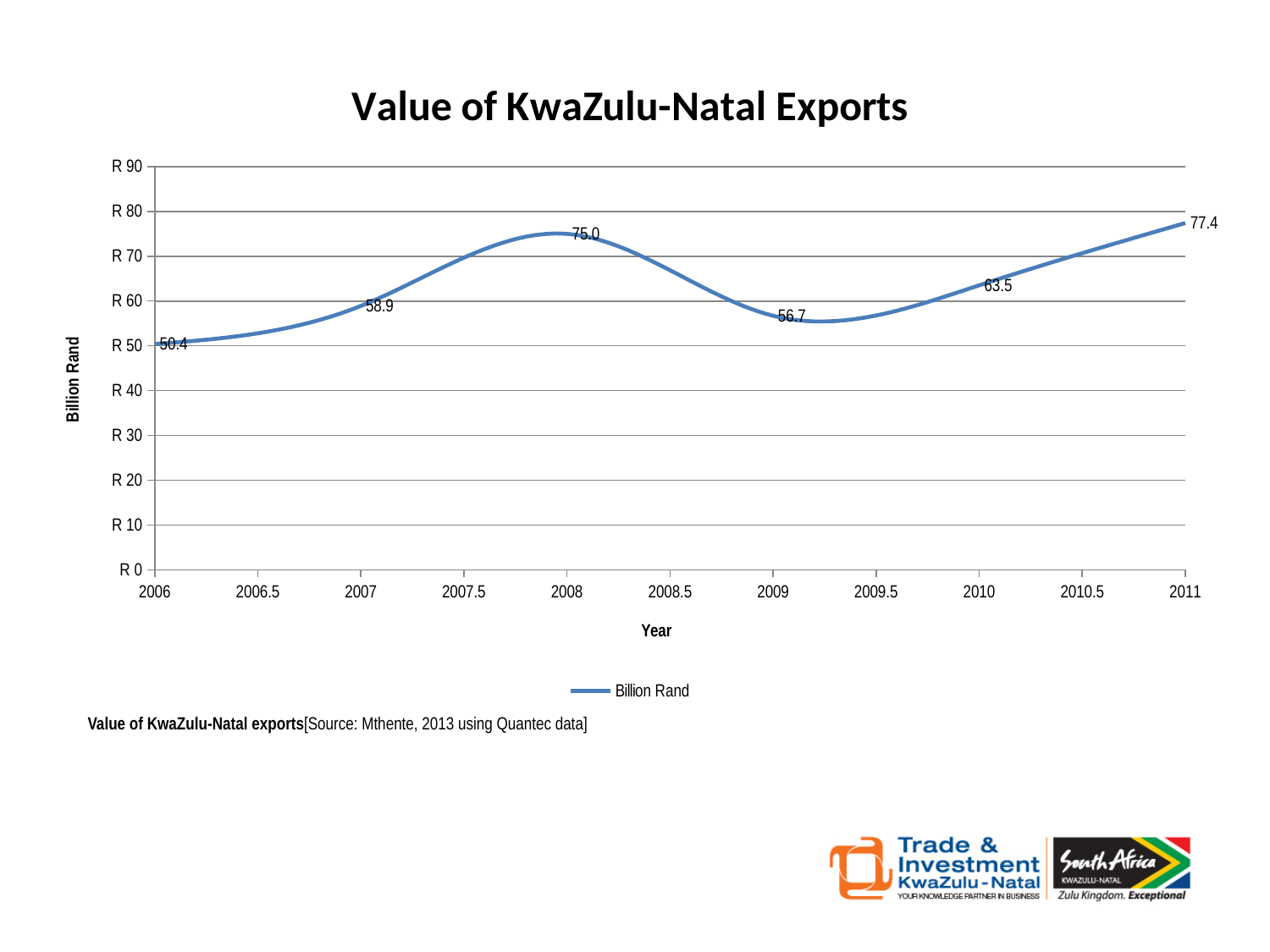
What is the difference between the export values for 2011 and 2006? 27.0 Is the export value for 2009 greater or less than R 60? less What is the label on the vertical axis of the chart? Billion Rand Which year has the highest export value? 2011 How many years are plotted on the chart? 6 What is the value of KwaZulu-Natal exports in 2008? 75.0 What is the value of KwaZulu-Natal exports in 2010? 63.5 Which year has the lowest export value? 2006 Which year has a larger export value, 2007 or 2009? 2007 What is the difference between the export values for 2008 and 2009? 18.3 What is the value of KwaZulu-Natal exports in 2006? 50.4 What kind of chart is shown on the slide? line chart